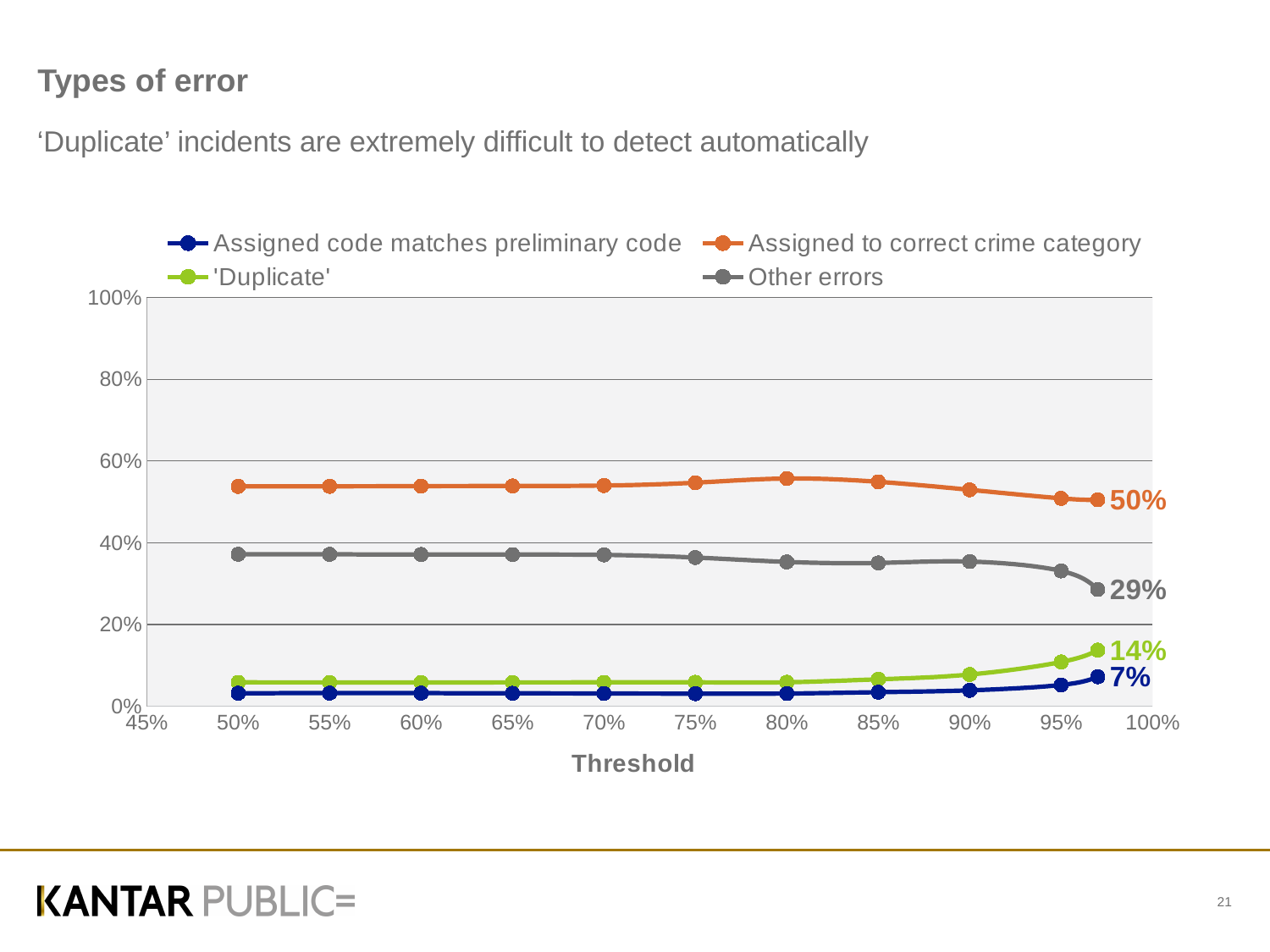
What type of chart is shown on the slide? Line chart What is the final labelled value for the 'Assigned to correct crime category' series? 50% What is the final labelled value for the 'Other errors' series? 29% Which series has the highest value at the end of the lines? Assigned to correct crime category What is the difference between the final labelled values of 'Assigned to correct crime category' and 'Other errors'? 21 percentage points How many series does the legend list? 4 What is the final labelled value for the 'Assigned code matches preliminary code' series? 7% Is the value for 'Other errors' at a threshold of 50% greater or less than 20%? greater What is the title of the x axis? Threshold Which series has the lowest value at the end of the lines? Assigned code matches preliminary code Does the 'Duplicate' series rise or fall as the threshold increases? Rises What is the final labelled value for the 'Duplicate' series? 14%